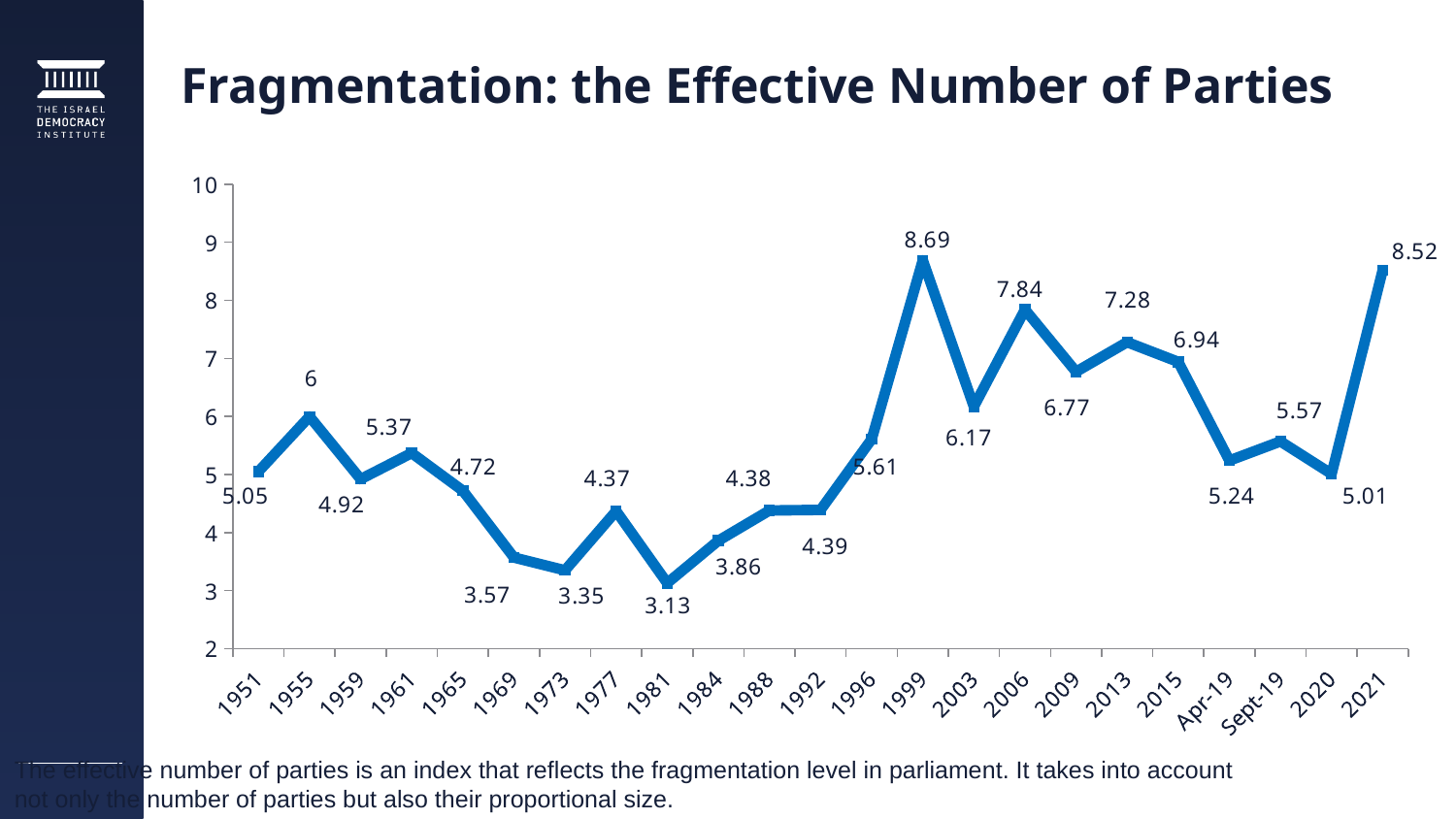
Does the effective number of parties rise or fall from 2015 to Apr-19? Fall What is the effective number of parties in 2021? 8.52 How many data points are plotted on the chart? 23 What is the difference between the values for 1999 and 2003? 2.52 What is the effective number of parties in 1999? 8.69 What is the difference between the values for 2021 and 2020? 3.51 Which year has the lowest effective number of parties? 1981 Which year has the highest effective number of parties? 1999 Which is larger, the value for 2006 or the value for 2013? 2006 What kind of chart is shown on the slide? Line chart What value is shown for 1955? 6 What is the title of the chart? Fragmentation: the Effective Number of Parties